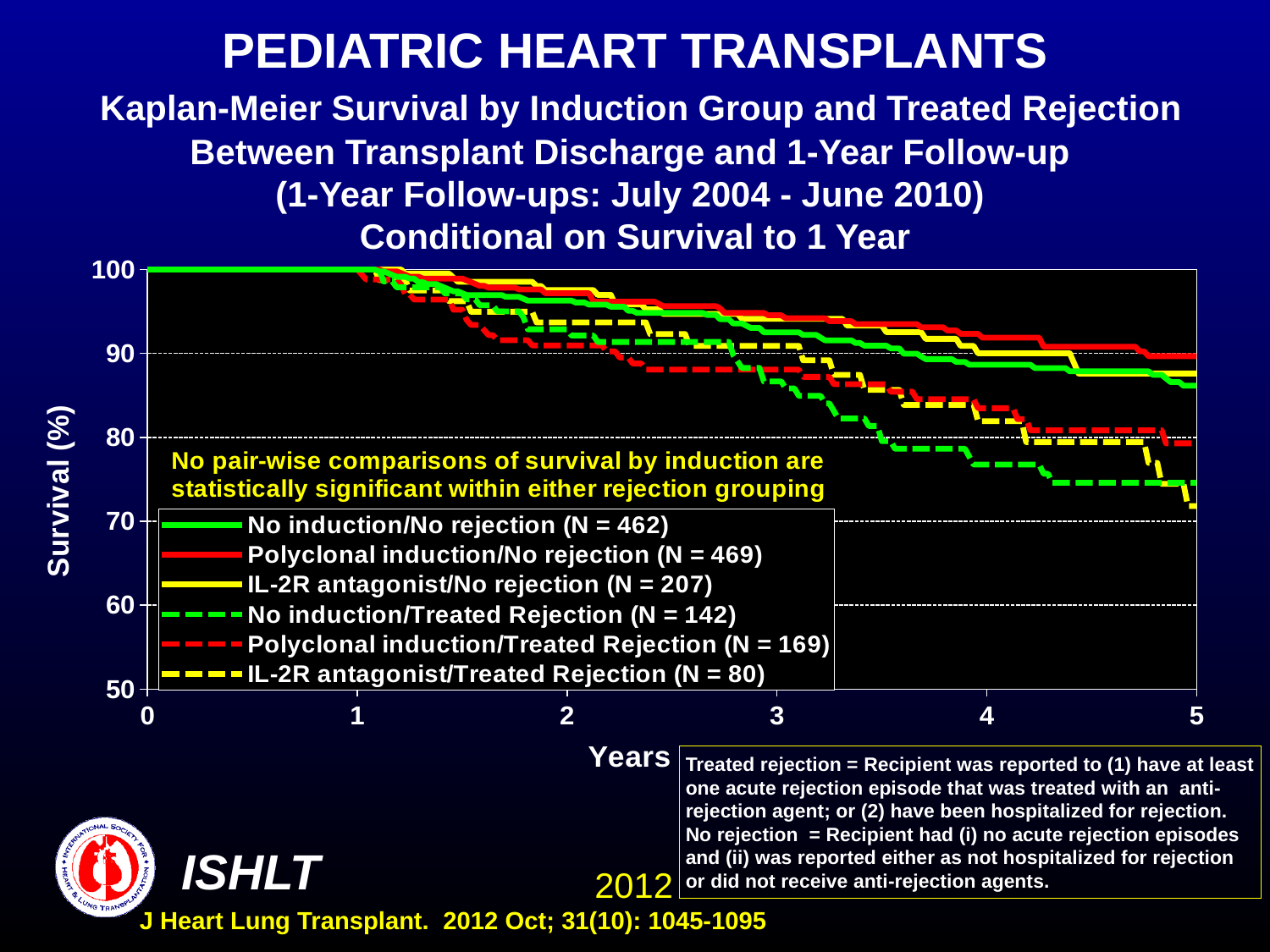
At 5 years, which has higher survival: Polyclonal induction/No rejection or No induction/Treated Rejection? Polyclonal induction/No rejection What is the N for the Polyclonal induction/No rejection group shown in the legend? 469 At 5 years, is the survival for No induction/Treated Rejection greater or less than 80? less At 5 years, is the survival for Polyclonal induction/No rejection greater or less than 80? greater What kind of chart is shown on the slide? line chart What is the label of the x axis? Years How many series does the legend list? 6 What is the N for the IL-2R antagonist/Treated Rejection group shown in the legend? 80 What is the N for the No induction/No rejection group shown in the legend? 462 Which group has the highest survival at 5 years? Polyclonal induction/No rejection Do the survival curves rise or fall as years increase? fall At 3 years, is the survival for Polyclonal induction/No rejection greater or less than 90? greater